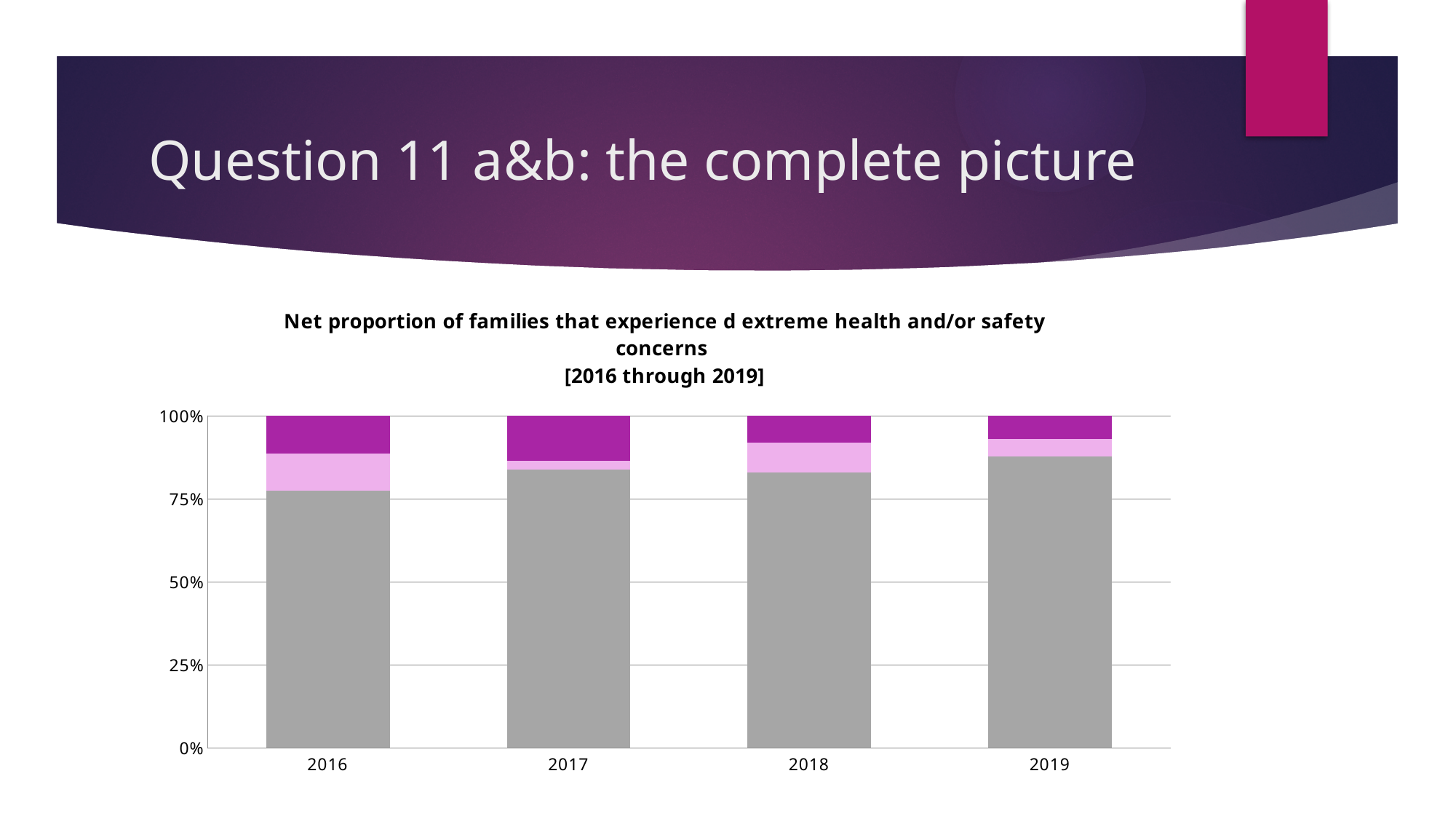
Is the gray segment for 2016 greater or less than 50%? greater Which year has the larger gray (bottom) segment, 2016 or 2019? 2019 In which year is the light pink (middle) segment the smallest? 2017 How many years are shown on the x axis of the chart? 4 What colour is the bottom segment of each stacked bar? Gray What is the title of the chart? Net proportion of families that experience d extreme health and/or safety concerns [2016 through 2019] What kind of chart is shown on the slide? Stacked bar chart In which year is the gray (bottom) segment the smallest? 2016 What value does each stacked bar total on the y axis? 100% In which year is the gray (bottom) segment the largest? 2019 Is the gray segment for 2017 greater or less than 75%? greater Is the gray segment for 2019 greater or less than 75%? greater